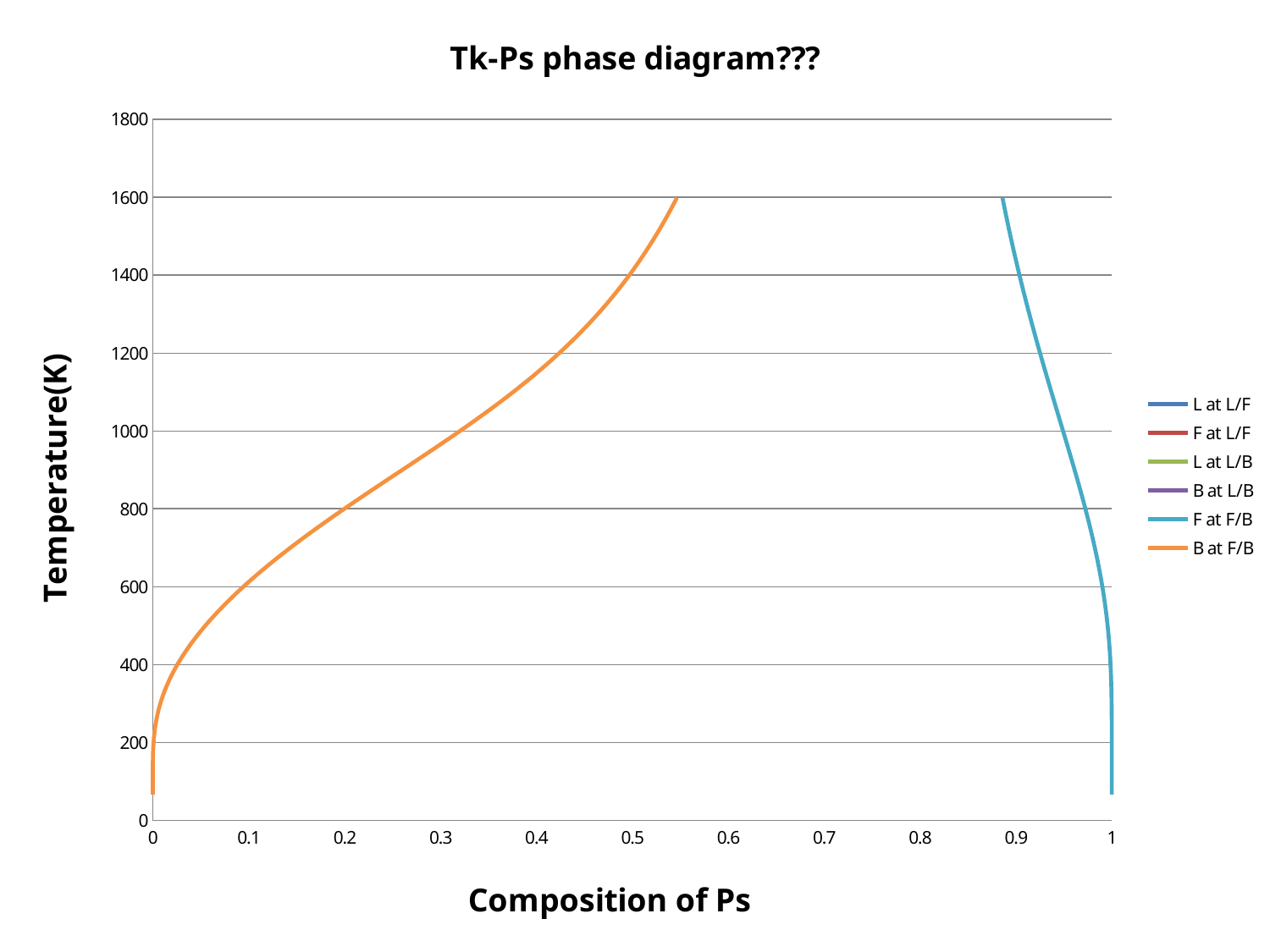
At 1600 K, which curve has the larger composition of Ps, F at F/B or B at F/B? F at F/B How many series does the legend list? 6 What is the label of the vertical axis? Temperature(K) Which series is drawn in orange? B at F/B At 1600 K, is the composition of Ps for the F at F/B curve greater or less than 0.9? less At 1600 K, is the composition of Ps for the B at F/B curve greater or less than 0.5? greater At 1200 K, is the composition of Ps for the B at F/B curve greater or less than 0.4? greater How many curves are actually visible in the plot area? 2 What is the title of the chart? Tk-Ps phase diagram??? What kind of chart is shown on the slide? line chart Along the B at F/B curve, does the composition of Ps increase or decrease as temperature rises? increase